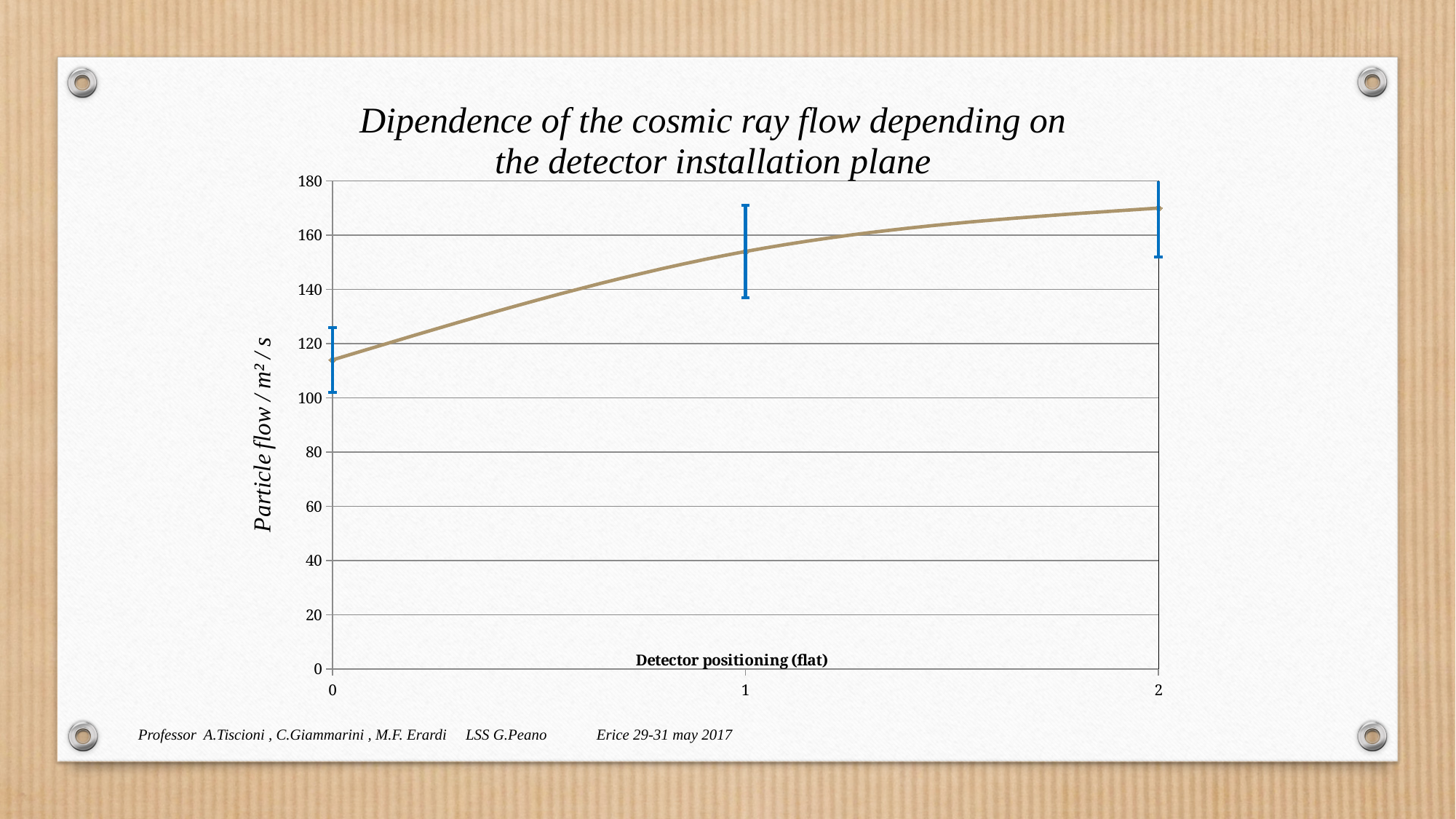
Do the particle flow values rise or fall as the detector positioning increases from 0 to 2? rise How many data points are plotted on the line? 3 Which detector positioning has the lowest particle flow? 0 Is the particle flow at detector positioning 0 greater or less than 120? less What is the label of the y axis? Particle flow / m² / s What is the label of the x axis? Detector positioning (flat) What kind of chart is shown on the slide? line chart Is the particle flow at detector positioning 1 greater or less than 140? greater Which has a larger particle flow, detector positioning 0 or detector positioning 1? 1 Is the particle flow at detector positioning 2 greater or less than 160? greater Which detector positioning has the highest particle flow? 2